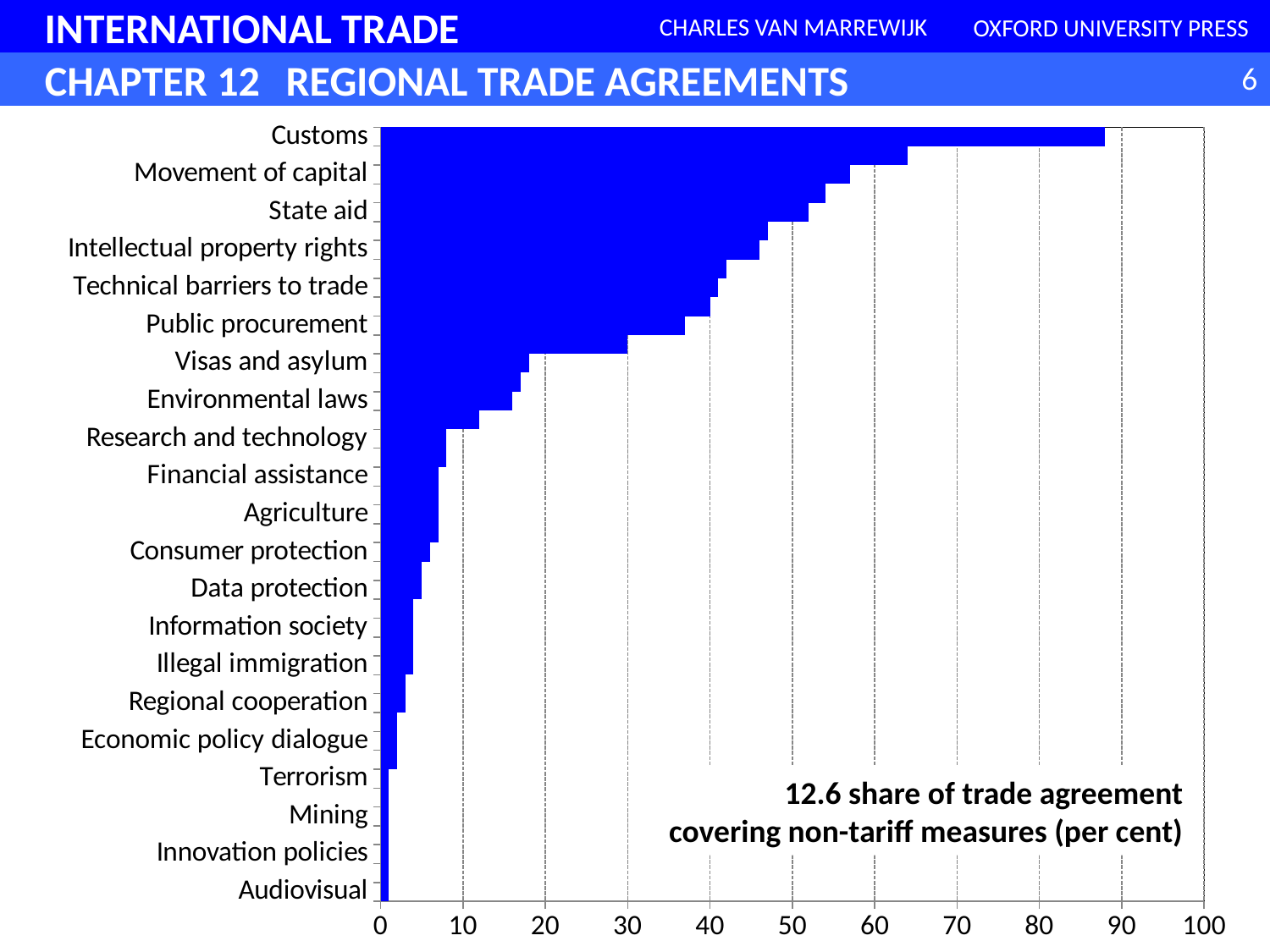
Is the value for Intellectual property rights greater or less than 60? less Which category has the highest share of trade agreements covering non-tariff measures? Customs What kind of chart is shown on the slide? Bar chart Do the bar values increase or decrease going from the top category to the bottom category? Decrease Is the value for Research and technology greater or less than 20? less Is the value for Movement of capital greater or less than 50? greater Which has a larger value, Customs or State aid? Customs What is the highest value shown on the horizontal axis? 100 Which has a larger value, Terrorism or Visas and asylum? Visas and asylum What is the title text printed inside the chart area? 12.6 share of trade agreement covering non-tariff measures (per cent)